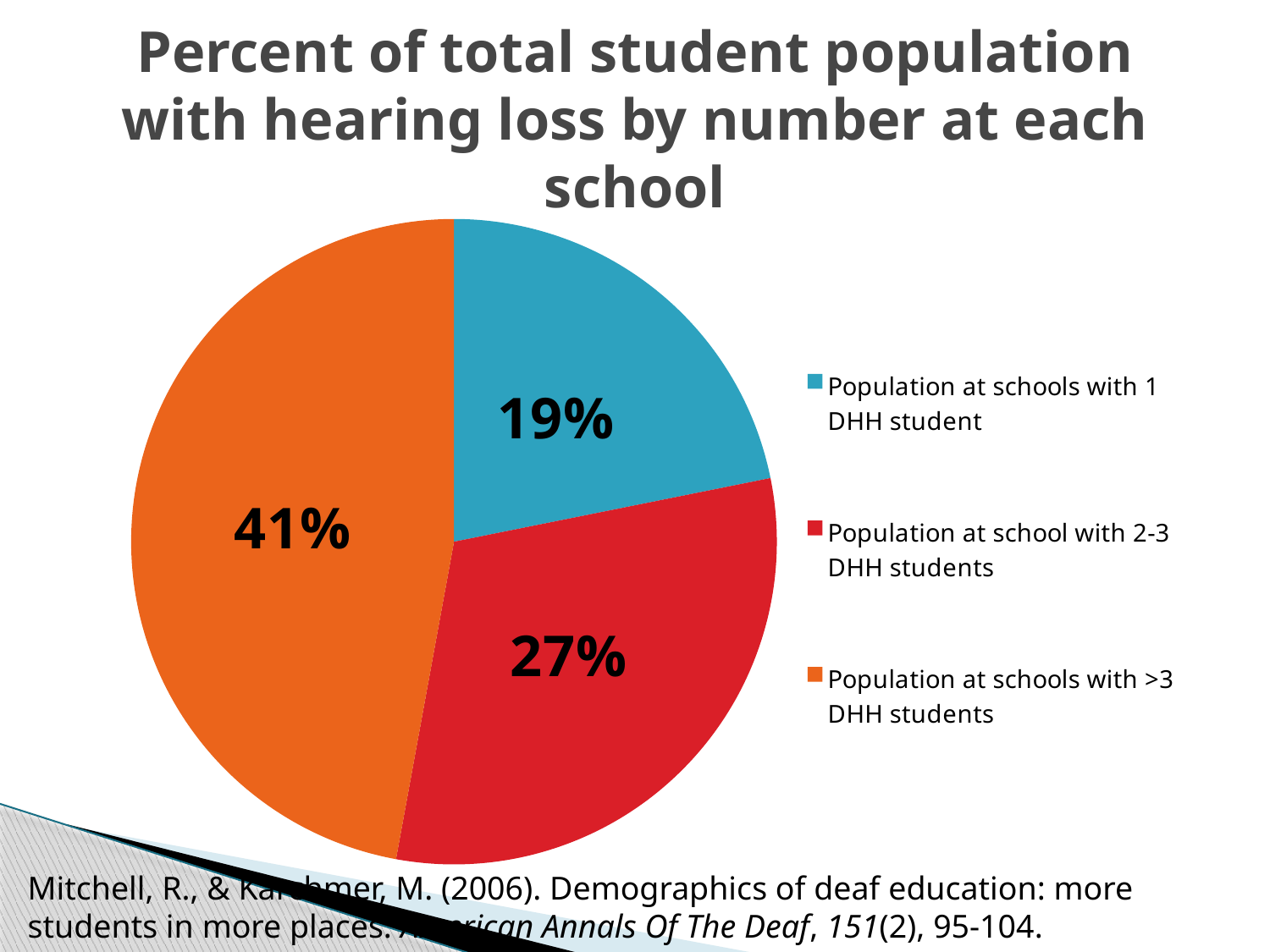
Which category has the smallest share of the pie? Population at schools with 1 DHH student How many entries does the legend list? 3 What kind of chart is shown on the slide? pie chart What colour is the slice for the population at schools with 1 DHH student? blue What percentage of the student population is at schools with 1 DHH student? 19% Which category has the largest share of the pie? Population at schools with >3 DHH students What percentage of the student population is at schools with 2-3 DHH students? 27% Which is larger: the share at schools with 2-3 DHH students or the share at schools with >3 DHH students? Population at schools with >3 DHH students What is the difference in percentage points between the share at schools with 2-3 DHH students and the share at schools with 1 DHH student? 8 How many slices does the pie chart have? 3 What is the difference in percentage points between the share at schools with >3 DHH students and the share at schools with 1 DHH student? 22 What percentage of the student population is at schools with >3 DHH students? 41%